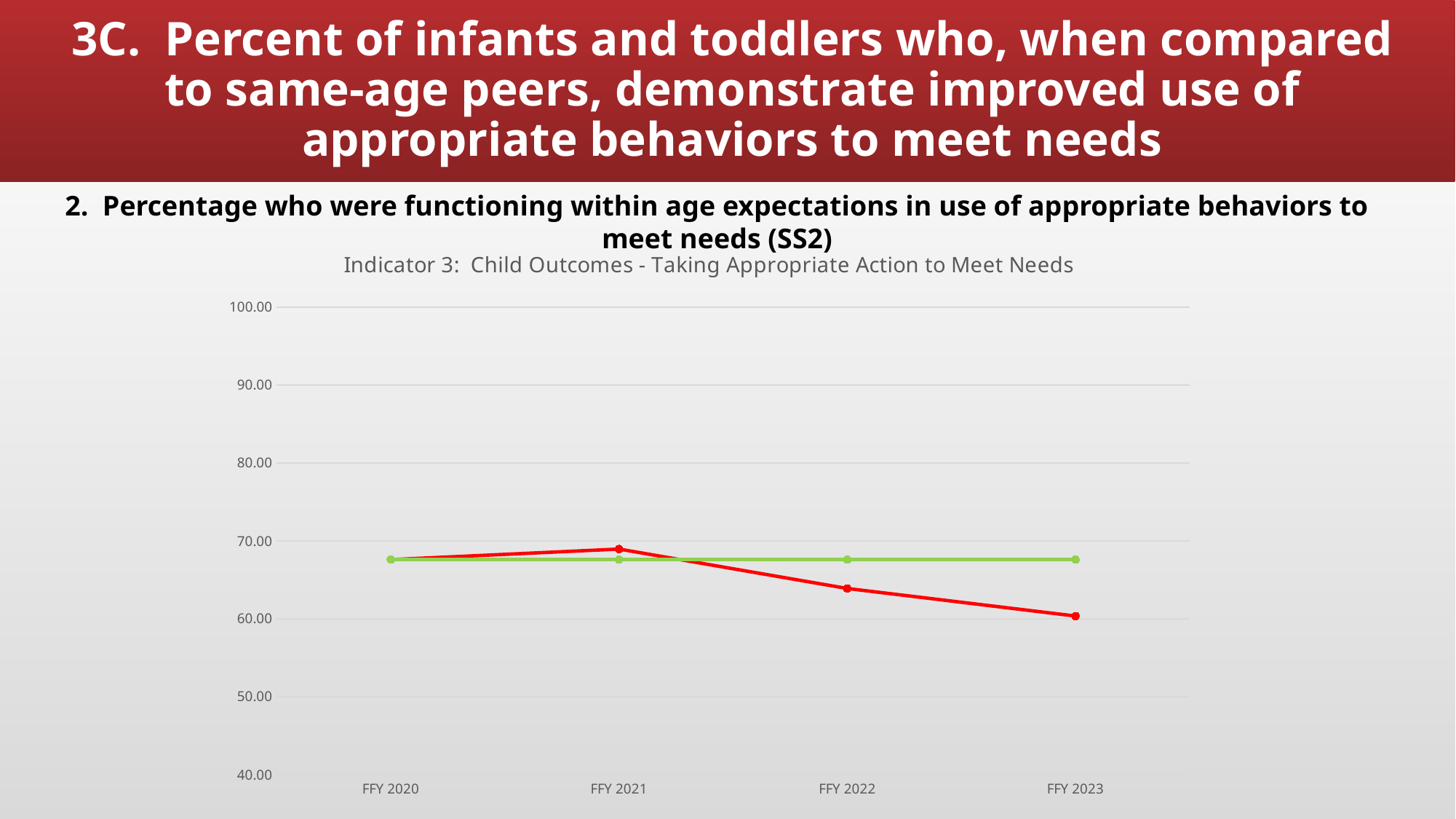
At FFY 2023, which line is higher, the red line or the green line? green line What is the title printed above the chart's plot area? Indicator 3: Child Outcomes - Taking Appropriate Action to Meet Needs Does the red line rise or fall from FFY 2021 to FFY 2023? fall In which fiscal year does the red line reach its highest value? FFY 2021 What kind of chart is shown on the slide? line chart Is the value of the red line for FFY 2023 greater or less than 70? less Is the value of the red line for FFY 2022 greater or less than 70? less Is the value of the green line for FFY 2020 greater or less than 60? greater In which fiscal year does the red line reach its lowest value? FFY 2023 How many fiscal years are shown on the x axis of the chart? 4 How many lines are plotted on the chart? 2